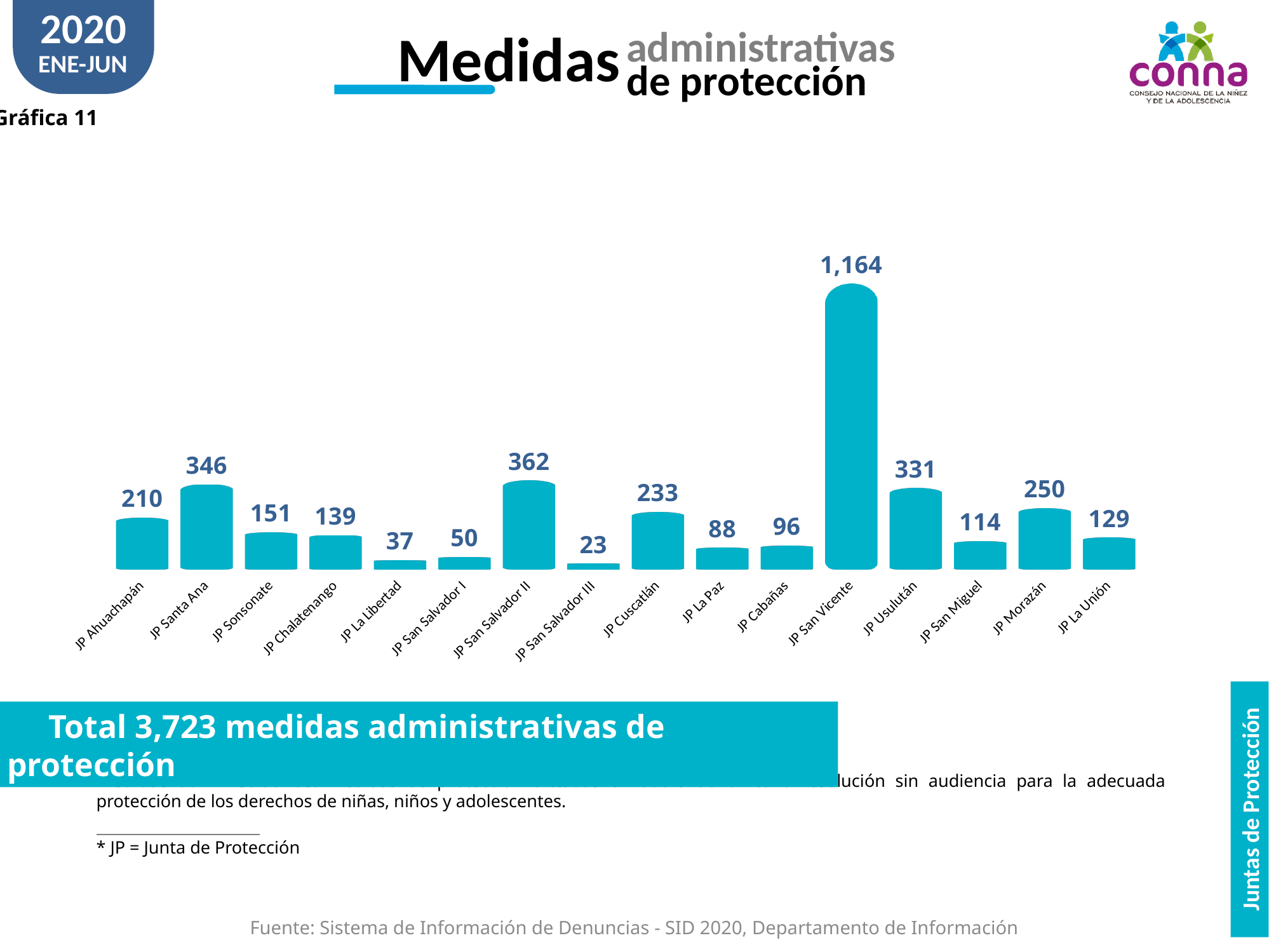
How many categories are shown on the x axis? 16 What is the value for JP Morazán? 250 What is the value for JP Chalatenango? 139 What kind of chart is shown on the slide? Bar chart Which category has the lowest value? JP San Salvador III What is the value for JP San Vicente? 1,164 Which is larger, the value for JP La Paz or the value for JP Cabañas? JP Cabañas Which is larger, the value for JP Cuscatlán or the value for JP Ahuachapán? JP Cuscatlán What is the difference between the values for JP Usulután and JP San Miguel? 217 What is the difference between the values for JP San Salvador II and JP Santa Ana? 16 Which category has the highest value? JP San Vicente What total of medidas administrativas de protección is stated on the slide? 3,723